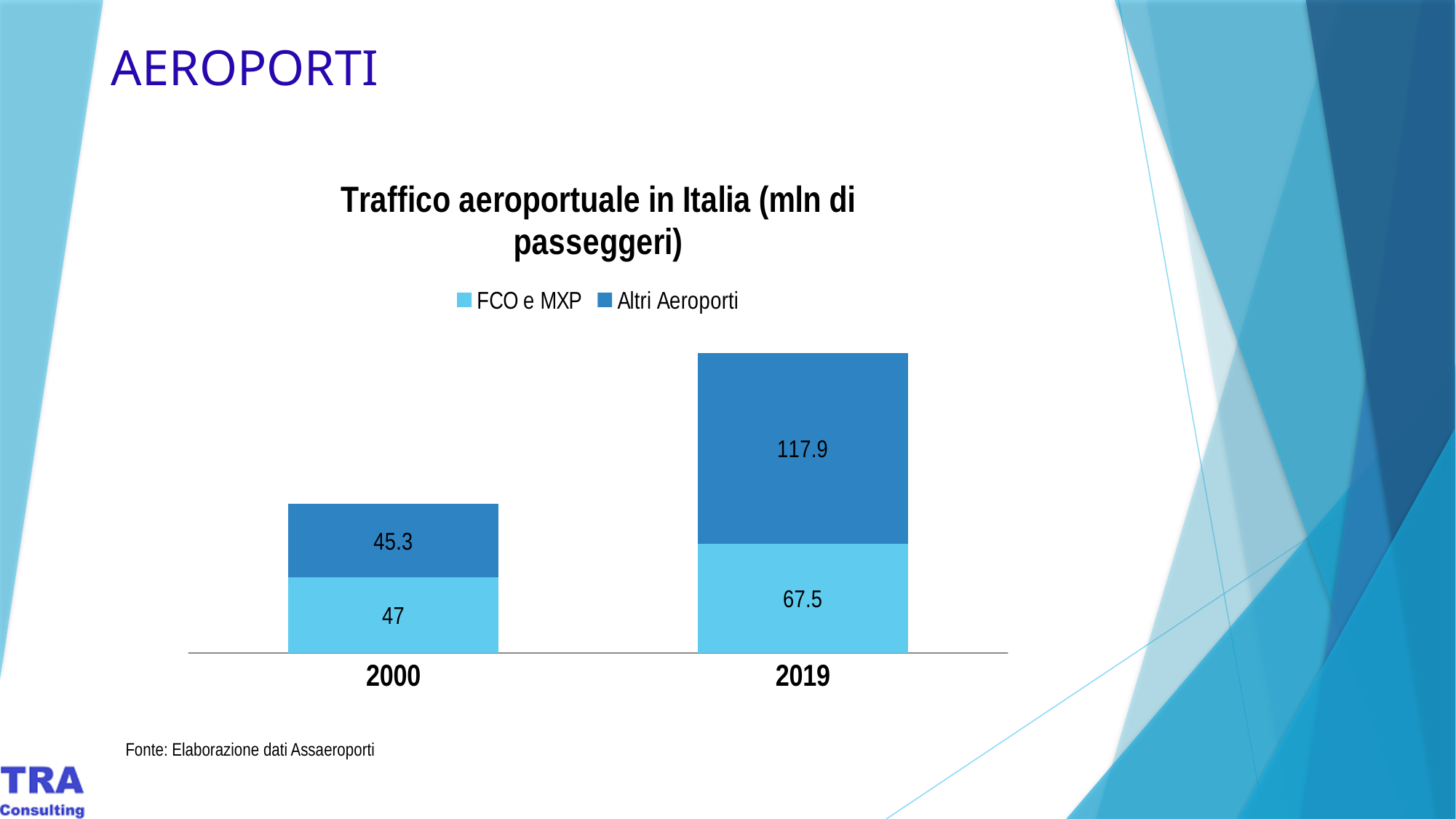
What is the value for FCO e MXP in 2000? 47 How many series does the legend list? 2 What kind of chart is shown? Stacked bar chart Which year has the higher total traffic? 2019 What is the value for Altri Aeroporti in 2019? 117.9 What is the value for FCO e MXP in 2019? 67.5 What is the total of the stacked bar for 2019? 185.4 What is the total of the stacked bar for 2000? 92.3 What is the difference between the Altri Aeroporti values for 2019 and 2000? 72.6 What is the title of the chart? Traffico aeroportuale in Italia (mln di passeggeri) What is the value for Altri Aeroporti in 2000? 45.3 Which is larger in 2019, FCO e MXP or Altri Aeroporti? Altri Aeroporti